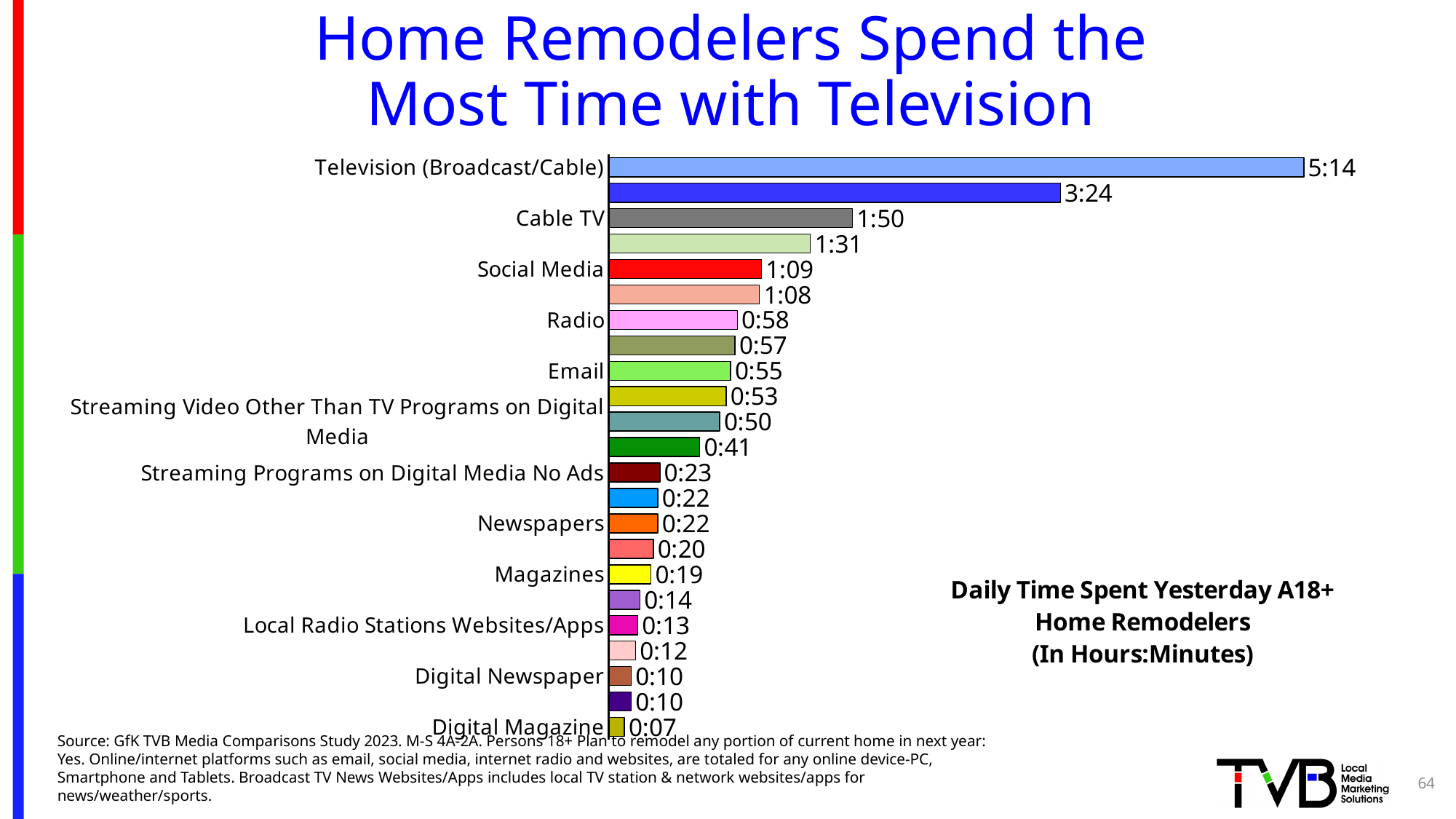
What is the daily time spent with Digital Magazine? 0:07 In what units are the values in the chart expressed, according to the chart's caption? Hours:Minutes Which category has the highest daily time spent? Television (Broadcast/Cable) What is the daily time spent with Radio? 0:58 How much more time is spent with Television (Broadcast/Cable) than with Cable TV? 3:24 What is the daily time spent with Cable TV? 1:50 What is the daily time spent with Social Media? 1:09 What is the daily time spent with Television (Broadcast/Cable) by home remodelers? 5:14 Which labeled category has the lowest daily time spent? Digital Magazine Which has a higher daily time spent, Email or Newspapers? Email How many bars are plotted in the chart? 23 What type of chart is shown on the slide? Bar chart